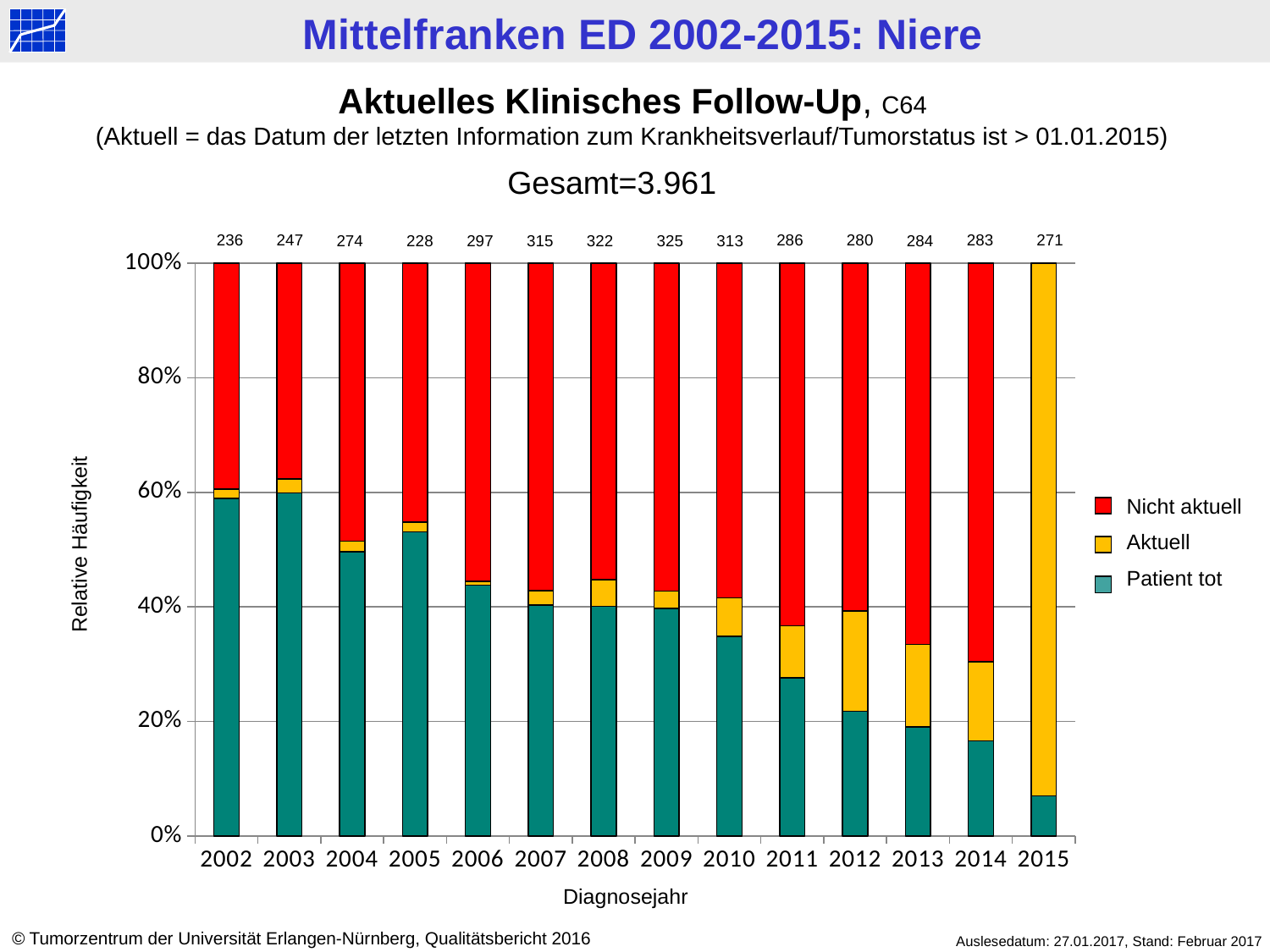
Which diagnosis year has the highest number printed above its bar? 2009 How many series does the legend list? 3 Is the 'Patient tot' share for 2002 greater or less than 40%? greater What is the number printed above the bar for 2009? 325 What kind of chart is shown on the slide? stacked bar chart Is the 'Patient tot' share for 2015 greater or less than 20%? less How many diagnosis years are shown on the x axis? 14 Does the 'Patient tot' share rise or fall from 2002 to 2015? fall Which year has the larger number printed above its bar, 2006 or 2007? 2007 What is the difference between the numbers printed above the bars for 2009 and 2005? 97 Which diagnosis year has the lowest number printed above its bar? 2005 What is the number printed above the bar for 2002? 236